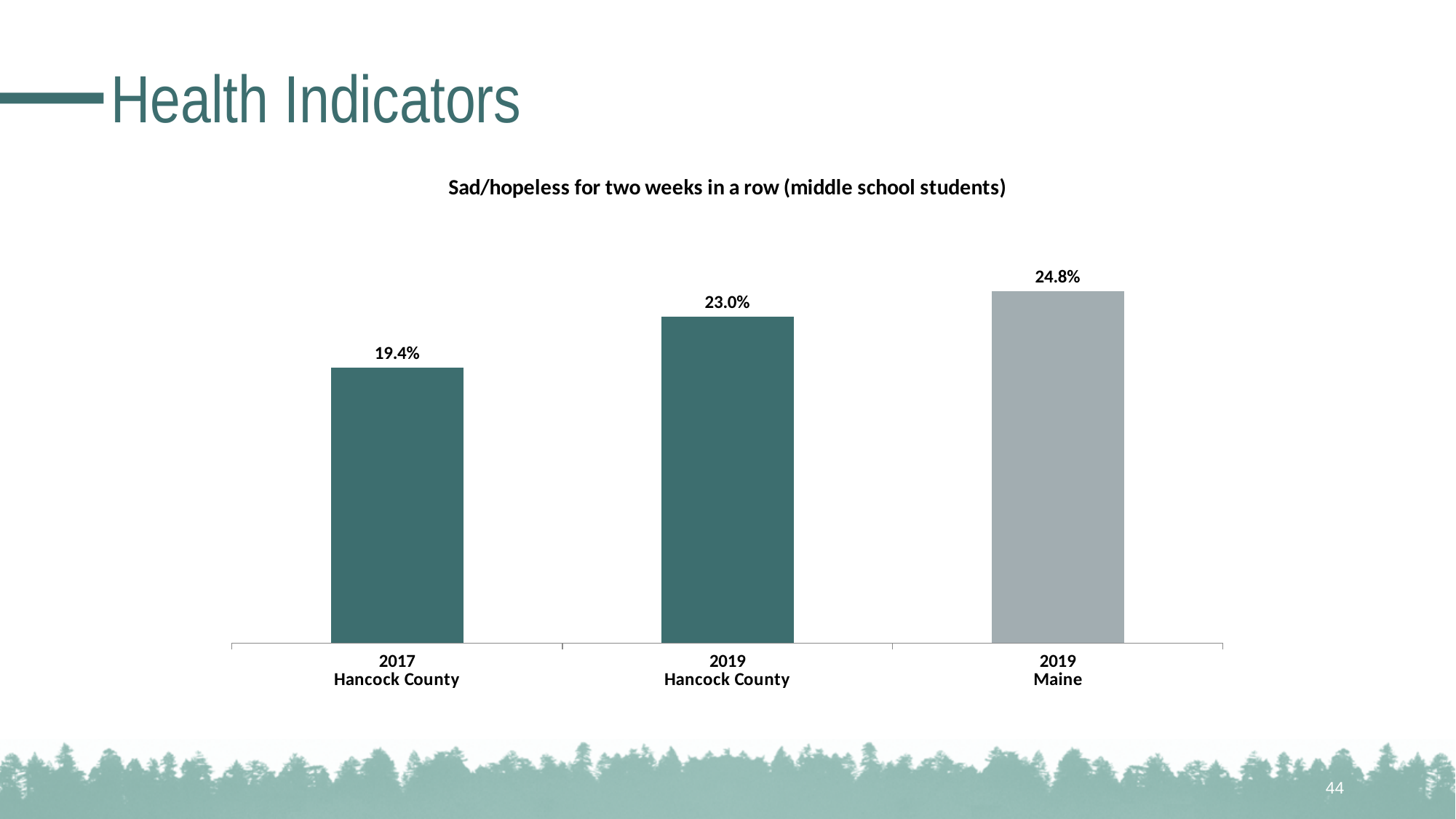
Which category has the highest value? 2019 Maine What is the title of the chart? Sad/hopeless for two weeks in a row (middle school students) What is the difference between the 2019 Hancock County value and the 2017 Hancock County value? 3.6% What kind of chart is shown on the slide? Bar chart What is the value for 2017 Hancock County? 19.4% Which is larger, the value for 2019 Hancock County or the value for 2019 Maine? 2019 Maine What is the value for 2019 Hancock County? 23.0% Which category has the lowest value? 2017 Hancock County What is the difference between the 2019 Maine value and the 2019 Hancock County value? 1.8% Do the values rise or fall from left to right across the chart? Rise How many bars are shown in the chart? 3 What is the value for 2019 Maine? 24.8%